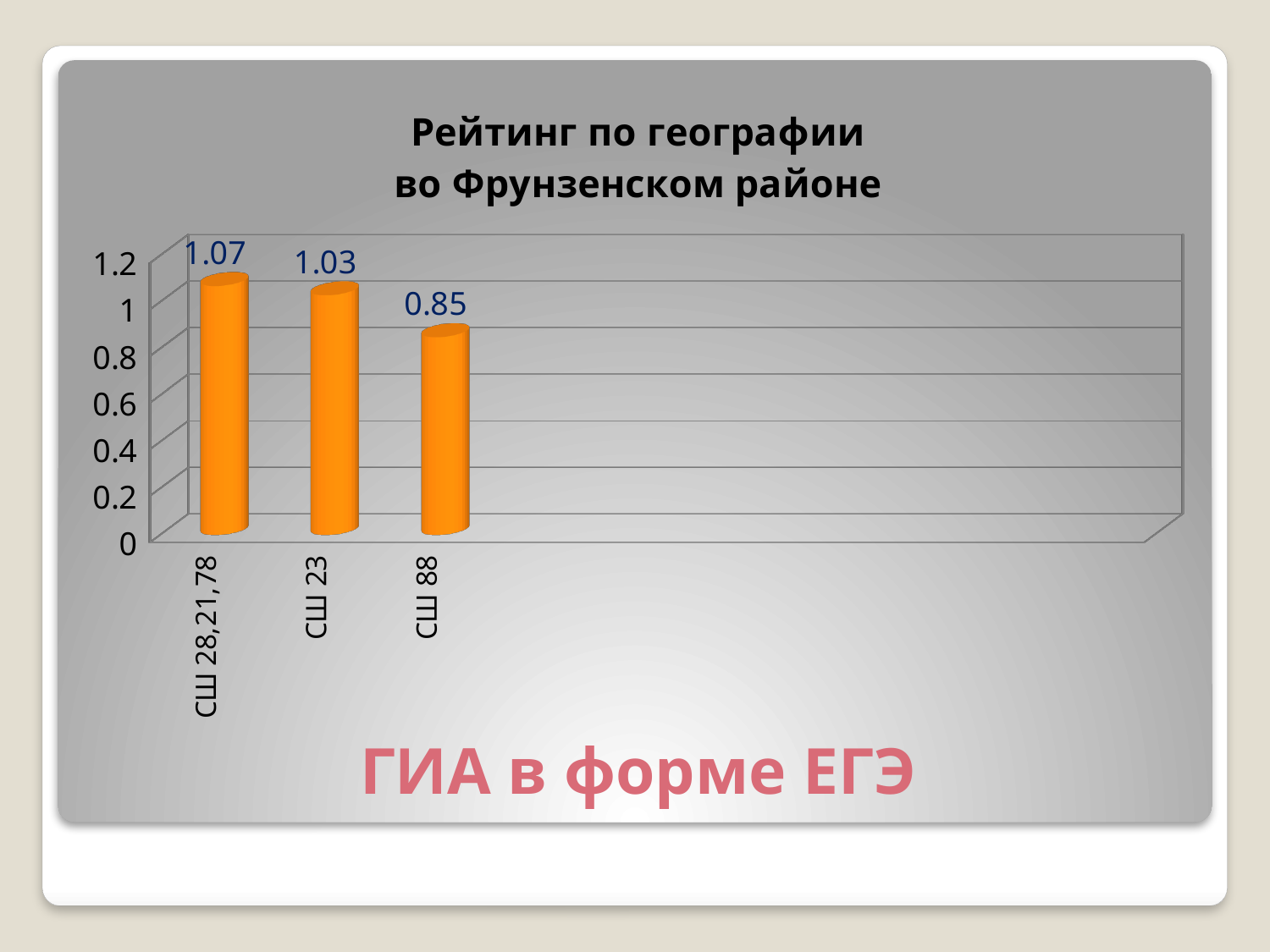
How many categories are shown in the chart? 3 Which category has the lowest value? СШ 88 What is the value for СШ 88? 0.85 Which is larger, the value for СШ 23 or the value for СШ 88? СШ 23 Which category has the highest value? СШ 28,21,78 What is the difference between the values for СШ 28,21,78 and СШ 88? 0.22 What kind of chart is shown on the slide? bar chart What is the value for СШ 28,21,78? 1.07 Is the value for СШ 88 greater or less than 1? less What is the title of the chart? Рейтинг по географии во Фрунзенском районе What is the value for СШ 23? 1.03 What is the difference between the values for СШ 23 and СШ 88? 0.18